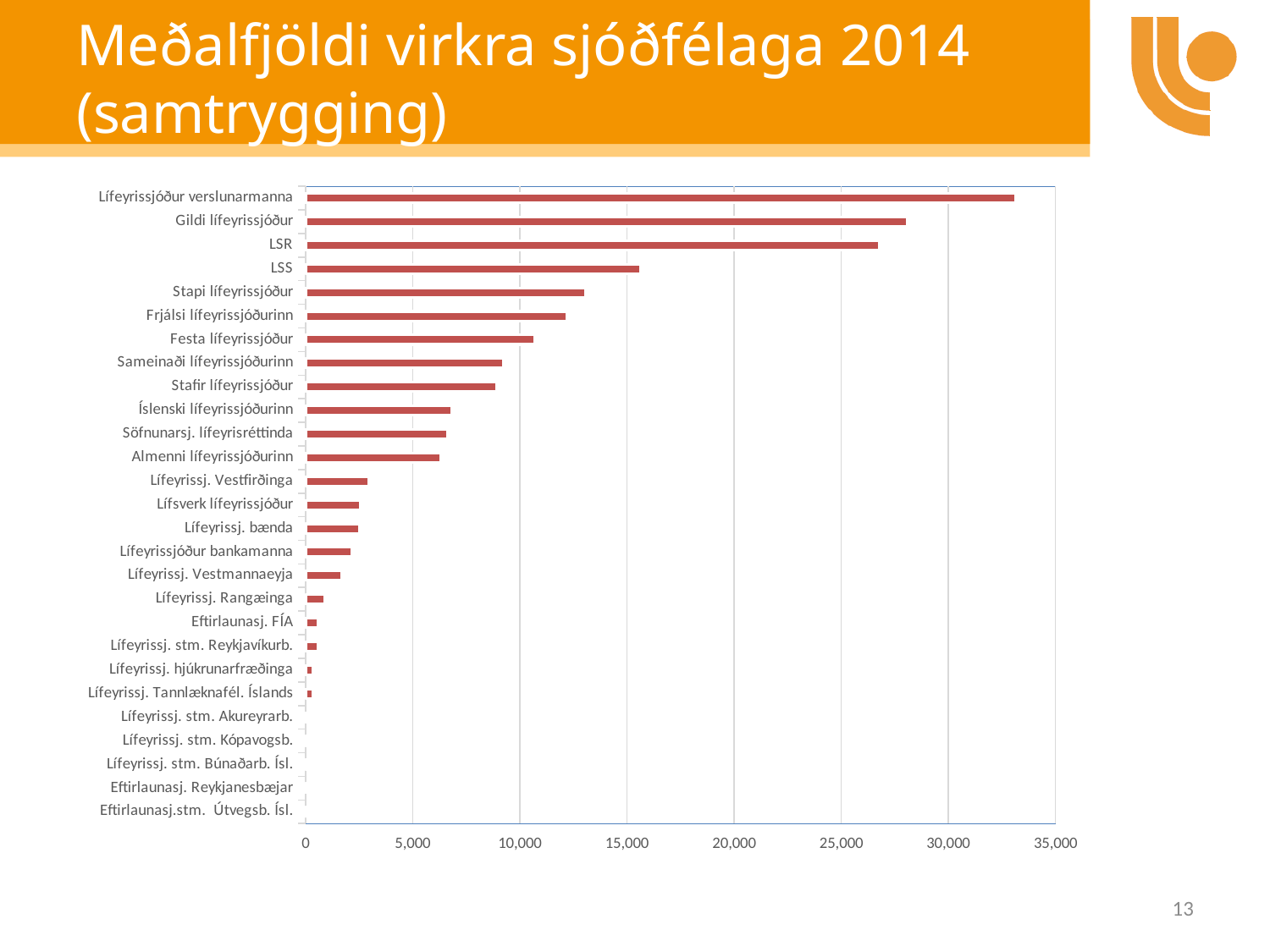
Is the value for Gildi lífeyrissjóður greater or less than 25,000? greater Is the value for Lífeyrissj. Vestfirðinga greater or less than 5,000? less How many categories (pension funds) are listed on the chart? 27 What kind of chart is shown on the slide? bar chart Is the value for Almenni lífeyrissjóðurinn greater or less than 5,000? greater Which has a larger value, LSR or Festa lífeyrissjóður? LSR Which has a larger value, LSS or Stapi lífeyrissjóður? LSS What is the title of the slide containing the chart? Meðalfjöldi virkra sjóðfélaga 2014 (samtrygging) Which pension fund has the highest average number of active members? Lífeyrissjóður verslunarmanna